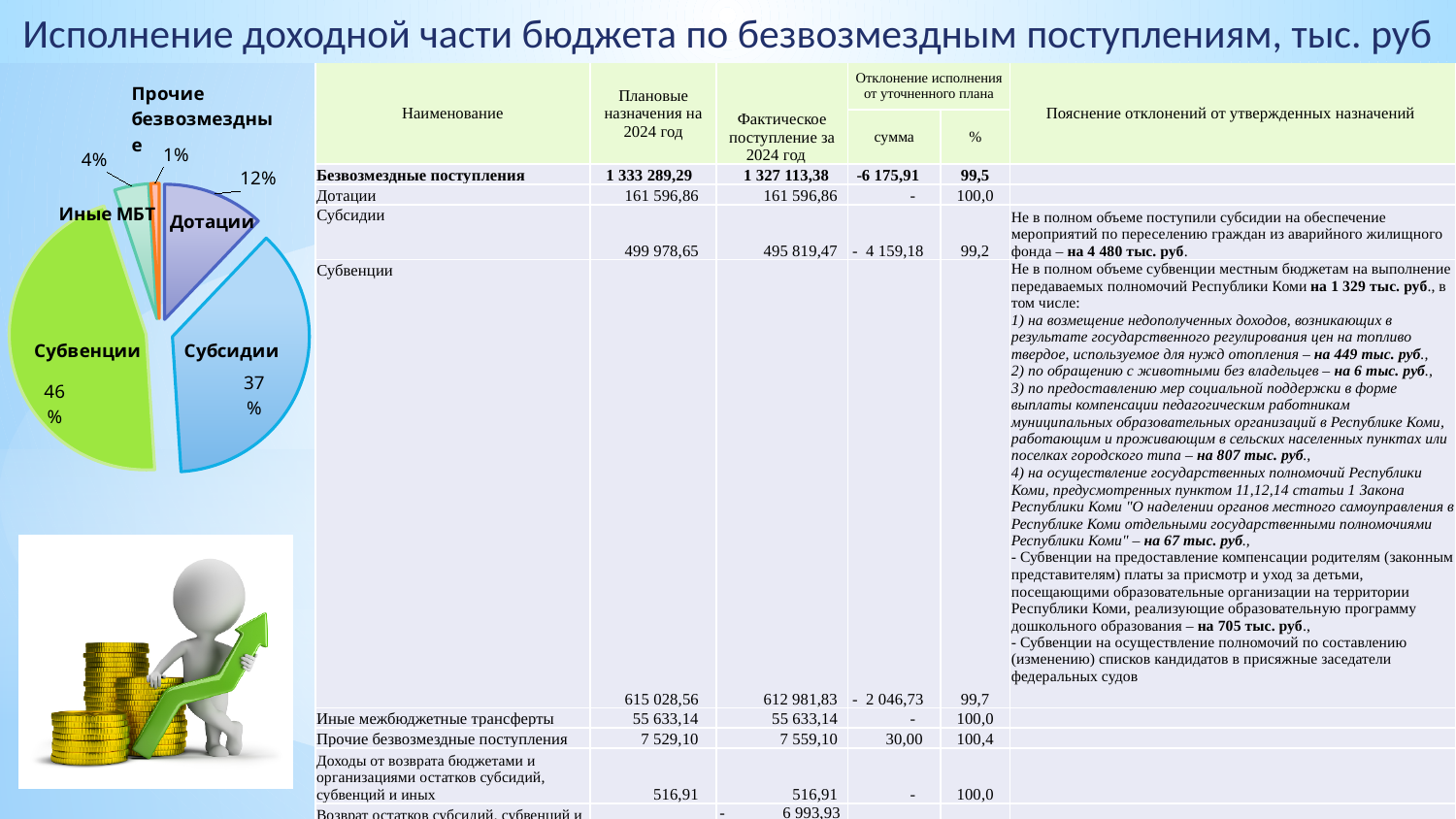
In the pie chart, what is the difference between the shares of Субвенции and Субсидии? 9% What kind of chart is shown on the left of the slide? pie chart In the pie chart, what share does Субсидии have? 37% In the pie chart, which is larger: Субсидии or Дотации? Субсидии How many slices does the pie chart have? 5 Which slice of the pie chart is the largest? Субвенции In the pie chart, what share does Субвенции have? 46% In the pie chart, what is the difference between the shares of Дотации and Иные МБТ? 8% In the pie chart, what share does Дотации have? 12% In the pie chart, what share does Иные МБТ have? 4% In the pie chart, what share does Прочие безвозмездные have? 1% Which slice of the pie chart is the smallest? Прочие безвозмездные